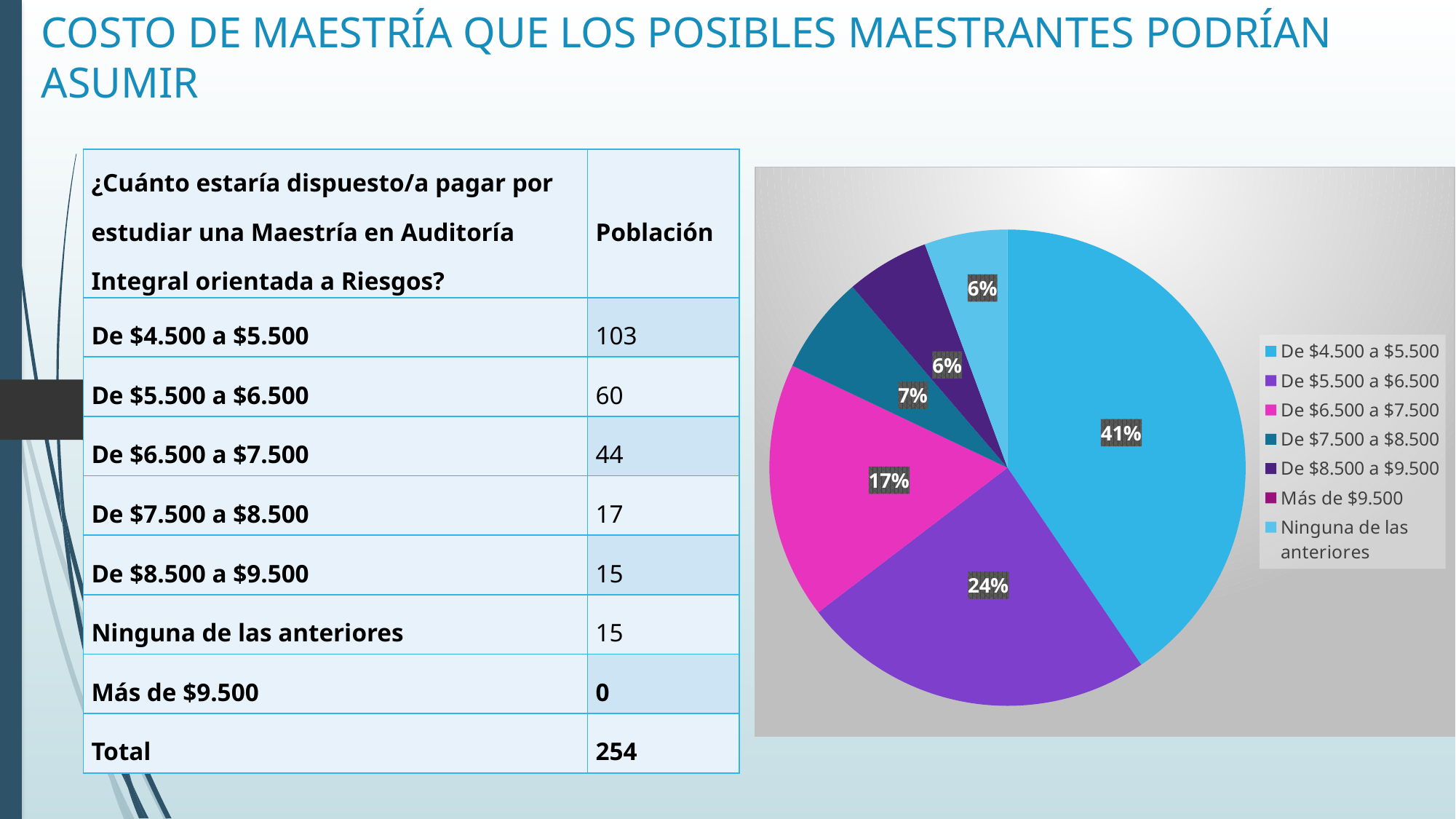
Which category has the largest slice of the pie? De $4.500 a $5.500 What percentage of the pie does the slice for 'De $4.500 a $5.500' represent? 41% What percentage is shown for the 'De $7.500 a $8.500' slice? 7% What percentage is shown for the 'De $6.500 a $7.500' slice? 17% How many slices with percentage labels are visible in the pie chart? 6 What is the difference in percentage points between the 'De $4.500 a $5.500' slice and the 'De $5.500 a $6.500' slice? 17 Which legend entry has no visible slice in the pie chart? Más de $9.500 What percentage is shown for the 'De $8.500 a $9.500' slice? 6% What percentage is shown for the 'De $5.500 a $6.500' slice? 24% Which slice is larger: 'De $6.500 a $7.500' or 'De $7.500 a $8.500'? De $6.500 a $7.500 How many entries does the legend of the pie chart list? 7 What kind of chart is shown on the slide? pie chart